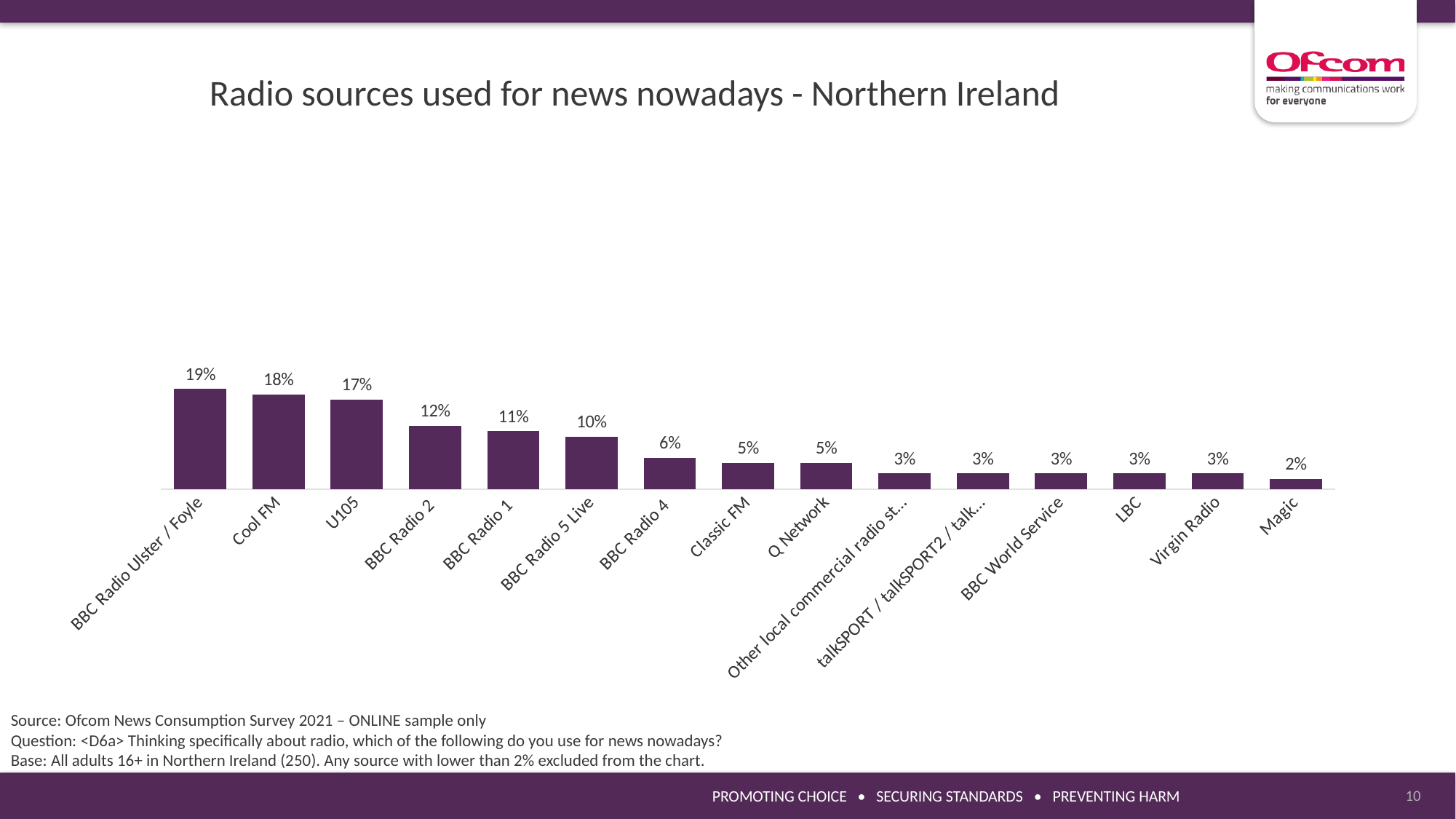
What is the difference between the values for U105 and BBC Radio 2? 5% What is the value shown for Cool FM? 18% How many radio sources are shown on the chart? 15 What is the difference between the values for BBC Radio 1 and BBC Radio 4? 5% What is the value shown for Classic FM? 5% What is the value shown for BBC Radio 5 Live? 10% Which has a higher value, Cool FM or BBC Radio 2? Cool FM Which radio source has the lowest value on the chart? Magic What percentage of adults use BBC Radio Ulster / Foyle for news nowadays? 19% Which radio source has the highest value on the chart? BBC Radio Ulster / Foyle What kind of chart is shown on the slide? Bar chart What is the title of the chart? Radio sources used for news nowadays - Northern Ireland